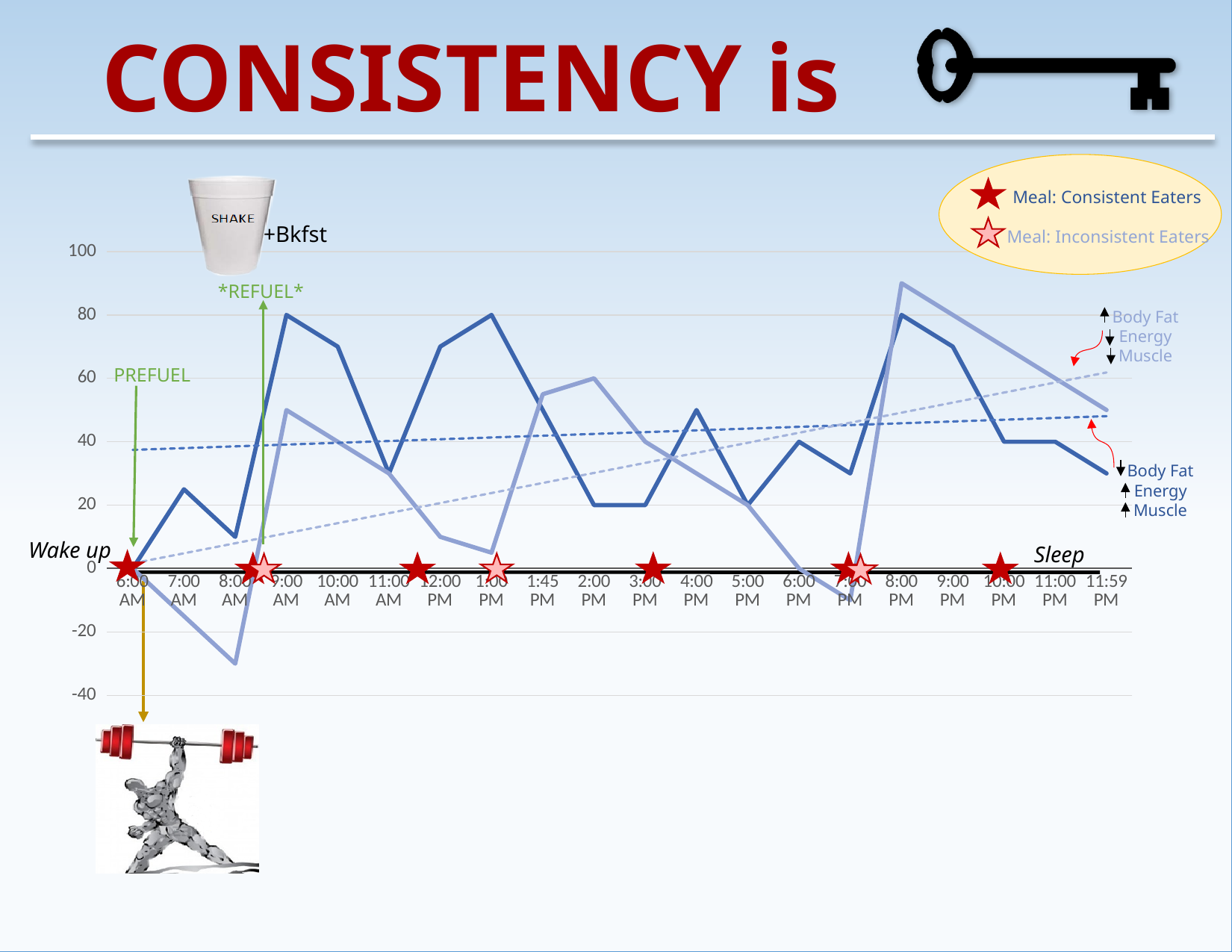
At which time does the light blue line reach its lowest value? 8:00 AM At 9:00 AM, which line has the higher value, the dark blue line or the light blue line? dark blue line Does the light blue dashed trend line rise or fall from left to right? rise What value does the dark blue line reach at 9:00 AM? 80 Is the value of the light blue line at 8:00 AM greater or less than -20? less How many time points are labelled along the x axis of the chart? 20 Is the value of the dark blue line at 4:00 PM greater or less than 40? greater At which time does the light blue line reach its highest value? 8:00 PM What value does the light blue line have at 2:00 PM? 60 What are the two entries in the star legend at the top right of the chart? Meal: Consistent Eaters; Meal: Inconsistent Eaters What kind of chart is shown on the slide? line chart What value does the dark blue line have at 2:00 PM? 20